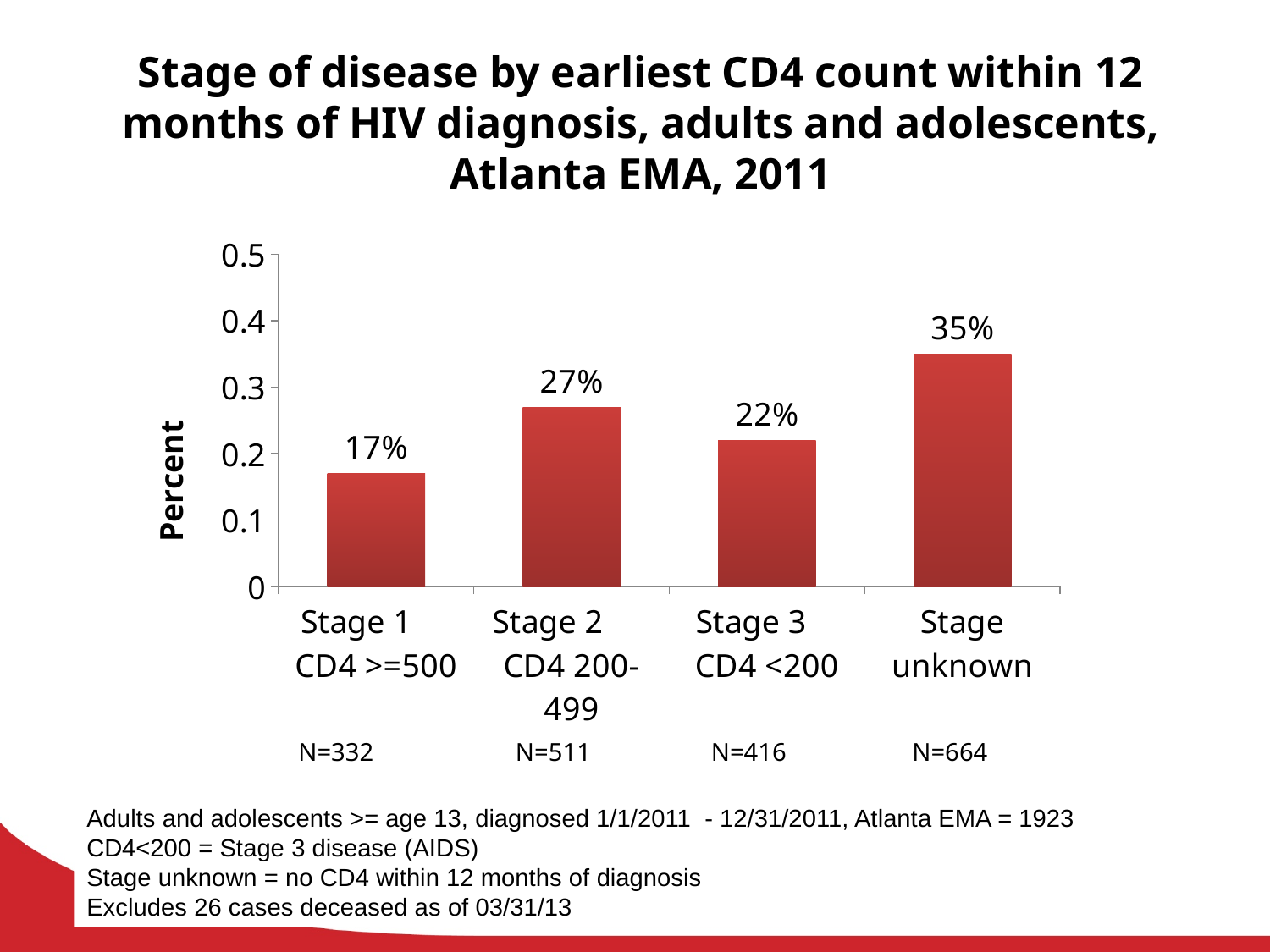
What kind of chart is shown on the slide? Bar chart What is the difference between the values for Stage unknown and Stage 1 CD4 >=500? 18% What is the value for Stage 3 CD4 <200? 22% Which is larger, the value for Stage 2 CD4 200-499 or Stage 3 CD4 <200? Stage 2 CD4 200-499 Which category has the highest value? Stage unknown What is the label of the y axis? Percent What is the value for Stage unknown? 35% What is the value for Stage 1 CD4 >=500? 17% What is the difference between the values for Stage 2 CD4 200-499 and Stage 3 CD4 <200? 5% What is the value for Stage 2 CD4 200-499? 27% How many categories are shown on the x axis? 4 Which category has the lowest value? Stage 1 CD4 >=500